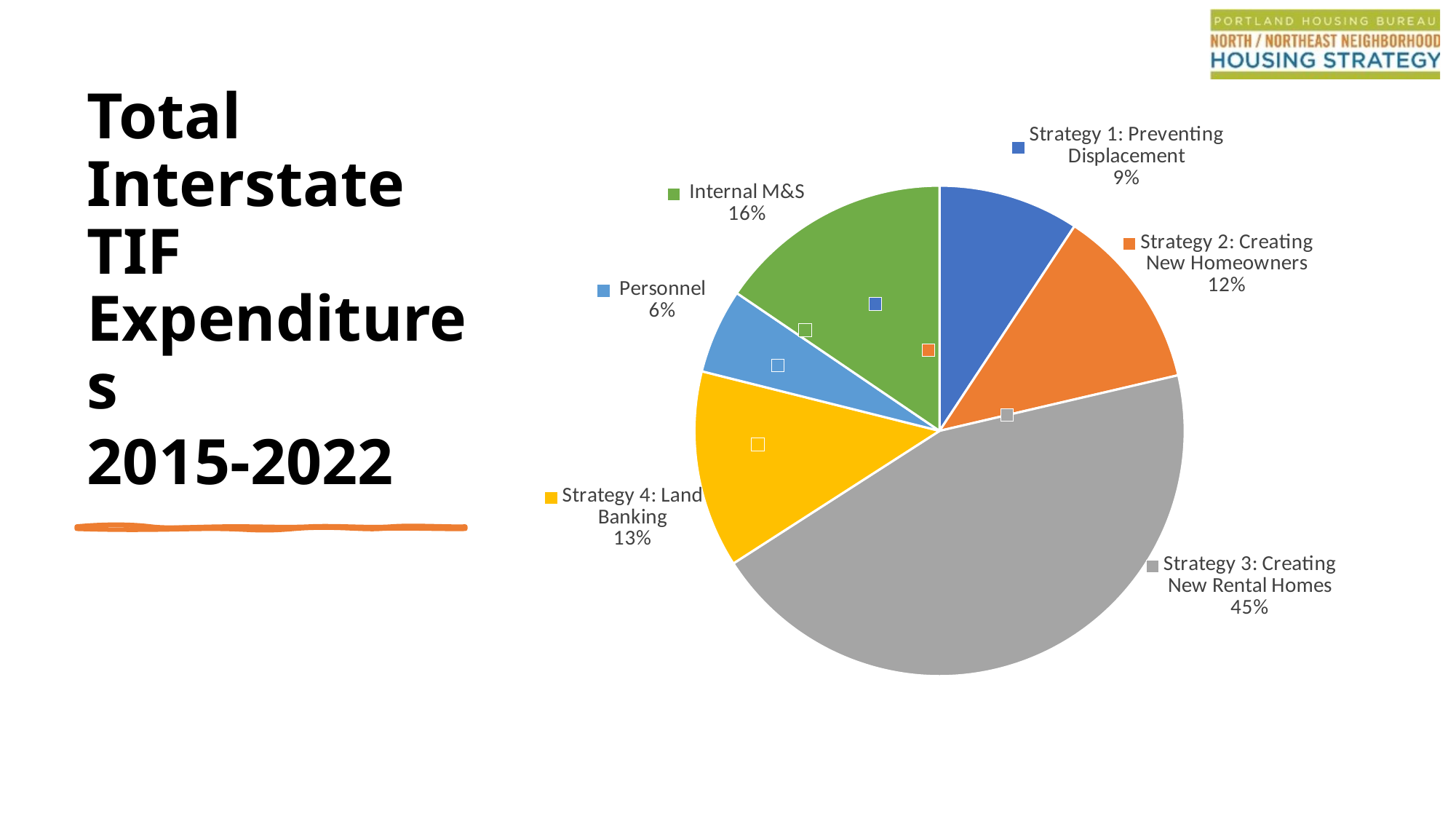
What percentage is shown for Internal M&S? 16% What percentage is shown for Strategy 4: Land Banking? 13% Which category has the smallest share of the pie? Personnel What percentage is shown for Personnel? 6% What percentage is shown for Strategy 1: Preventing Displacement? 9% What is the difference in percentage points between Strategy 3: Creating New Rental Homes and Strategy 2: Creating New Homeowners? 33 What kind of chart is shown on the slide? pie chart How many slices does the pie chart have? 6 Which category has the largest share of the pie? Strategy 3: Creating New Rental Homes What is the title of the slide containing the chart? Total Interstate TIF Expenditures 2015-2022 Which is larger, the share for Internal M&S or the share for Strategy 4: Land Banking? Internal M&S What share of expenditures goes to Strategy 3: Creating New Rental Homes? 45%